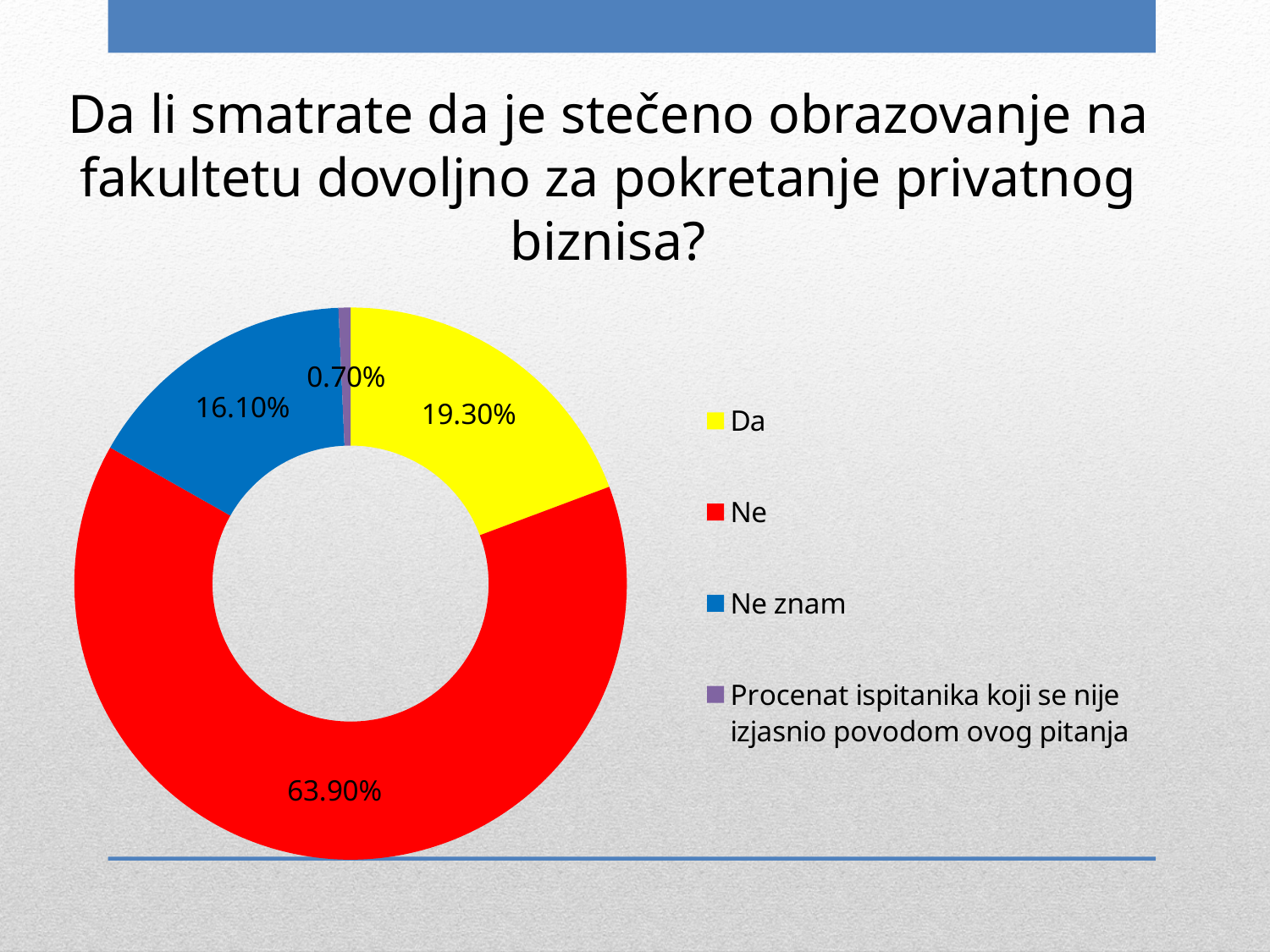
What is the difference in percentage points between "Da" and "Ne znam"? 3.20% What percentage of respondents answered "Ne"? 63.90% Which category has the largest share of the chart? Ne Which category has the smallest share of the chart? Procenat ispitanika koji se nije izjasnio povodom ovog pitanja What kind of chart is shown on the slide? Doughnut chart What percentage is shown for "Procenat ispitanika koji se nije izjasnio povodom ovog pitanja"? 0.70% What percentage of respondents answered "Da"? 19.30% How many categories does the legend list? 4 What percentage of respondents answered "Ne znam"? 16.10% What colour represents the "Ne" category? Red What is the difference in percentage points between "Ne" and "Da"? 44.60% Which is larger, the share for "Da" or the share for "Ne znam"? Da